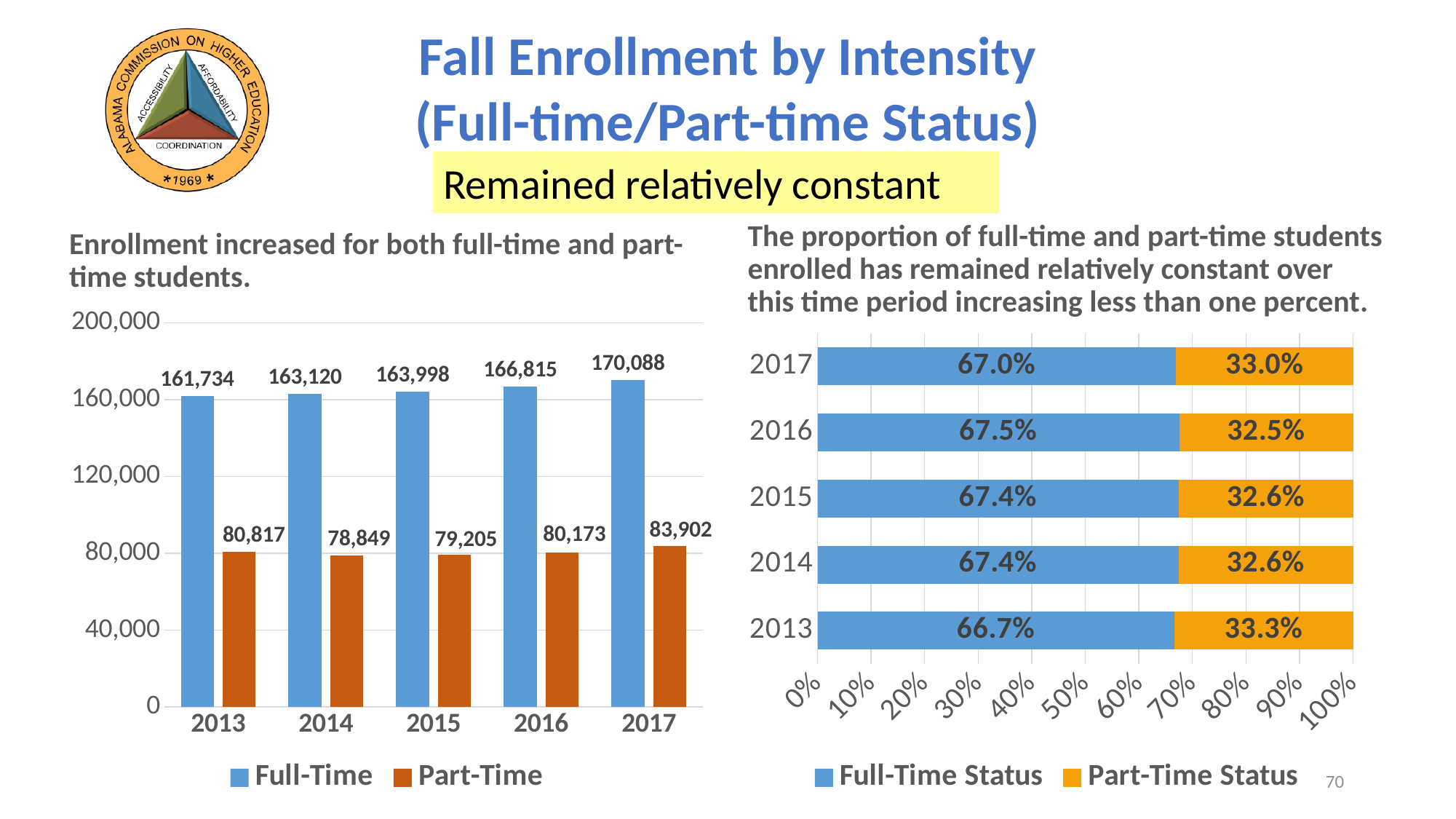
What kind of chart is the right chart? stacked bar chart In the right chart, what was the Full-Time Status share in 2016? 67.5% In the right chart, how many years are shown? 5 In the left chart, what was the Part-Time enrollment in 2014? 78,849 In the right chart, what was the Part-Time Status share in 2013? 33.3% In the left chart, which year had the highest Full-Time enrollment? 2017 In the left chart, what is the difference between Full-Time and Part-Time enrollment in 2013? 80,917 In the left chart, does Full-Time enrollment rise or fall from 2013 to 2017? rise In the right chart, which year had the highest Part-Time Status share? 2013 In the left chart, how many series does the legend list? 2 In the left chart, which year had the lowest Part-Time enrollment? 2014 In the left chart, what was the Full-Time enrollment in 2017? 170,088